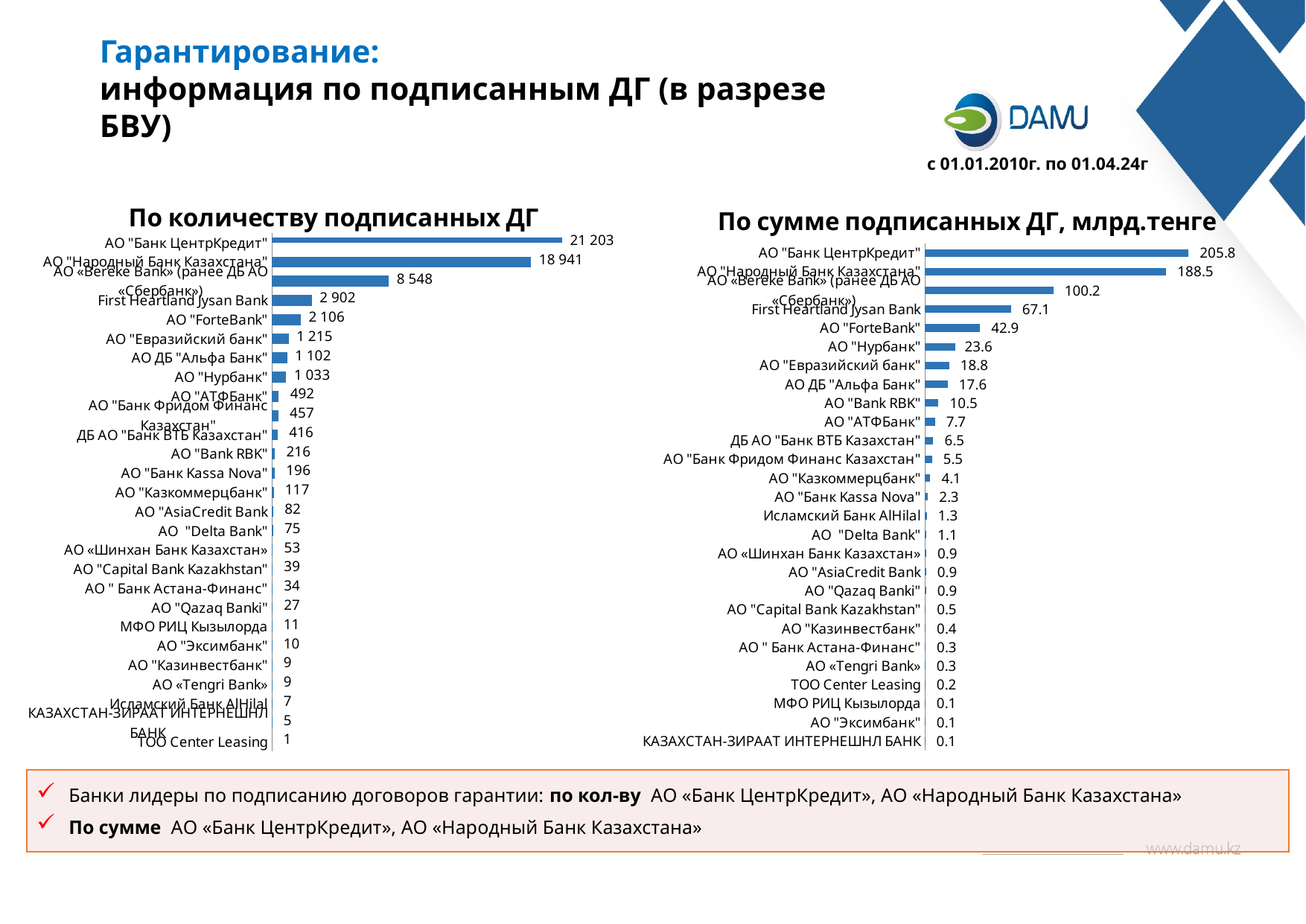
On the chart "По количеству подписанных ДГ", what is the difference between АО "Банк ЦентрКредит" and АО "Народный Банк Казахстана"? 2 262 How many banks are listed on the chart "По сумме подписанных ДГ, млрд.тенге"? 27 What type of chart is "По количеству подписанных ДГ"? Bar chart On the chart "По сумме подписанных ДГ, млрд.тенге", what is the difference between First Heartland Jysan Bank and АО "ForteBank"? 24.2 On the chart "По сумме подписанных ДГ, млрд.тенге", which is larger: АО "Bank RBK" or АО "АТФБанк"? АО "Bank RBK" On the chart "По количеству подписанных ДГ", what is the value for АО "Банк ЦентрКредит"? 21 203 On the chart "По сумме подписанных ДГ, млрд.тенге", which bank has the highest value? АО "Банк ЦентрКредит" On the chart "По количеству подписанных ДГ", which is larger: АО "Евразийский банк" or АО ДБ "Альфа Банк"? АО "Евразийский банк" On the chart "По количеству подписанных ДГ", what is the value for АО "ForteBank"? 2 106 On the chart "По количеству подписанных ДГ", which bank has the lowest value? ТОО Center Leasing On the chart "По сумме подписанных ДГ, млрд.тенге", what is the value for АО «Bereke Bank» (ранее ДБ АО «Сбербанк»)? 100.2 On the chart "По сумме подписанных ДГ, млрд.тенге", what is the value for АО "Нурбанк"? 23.6